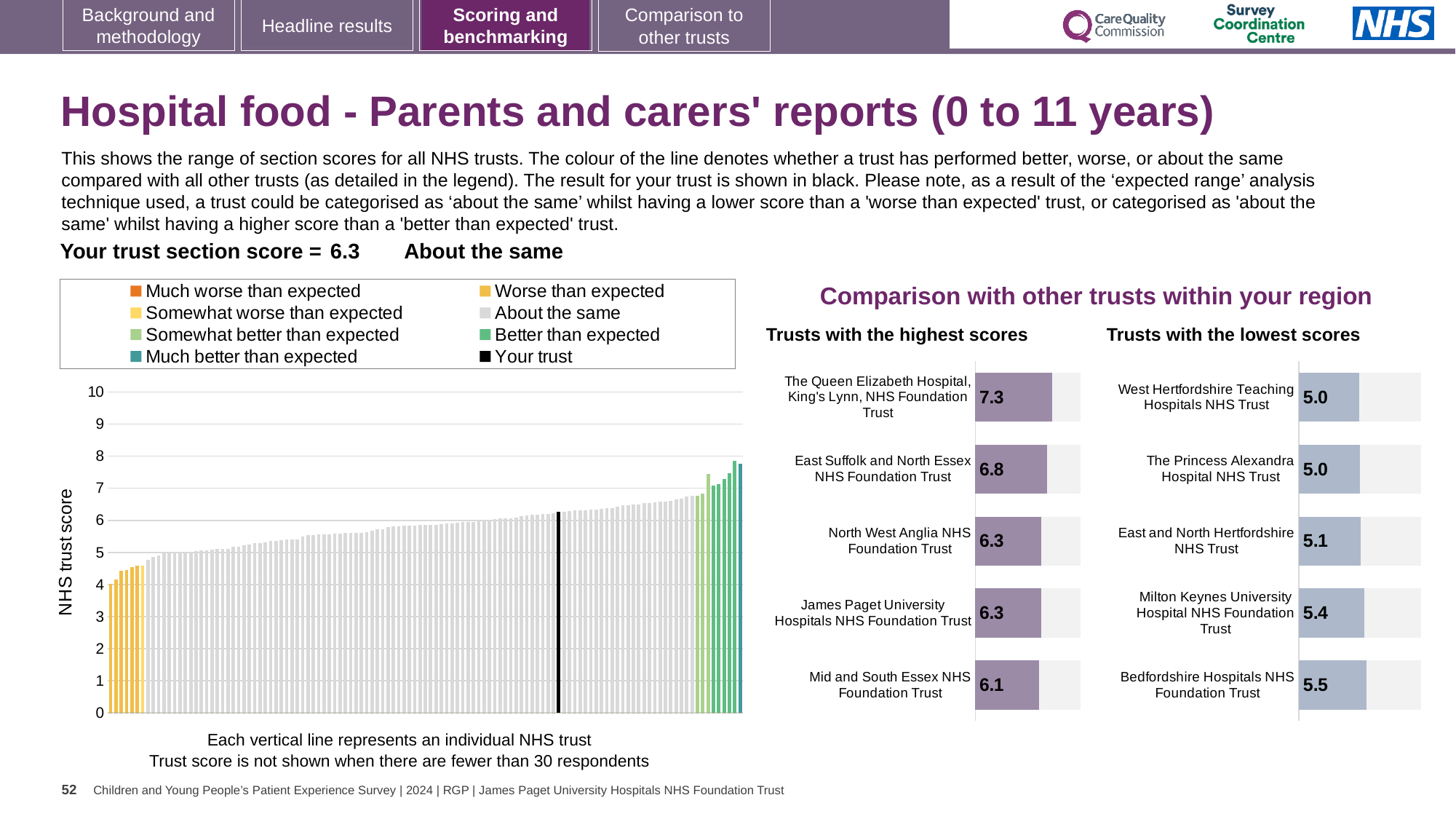
In the 'Trusts with the highest scores' chart, which trust has the highest score? The Queen Elizabeth Hospital, King's Lynn, NHS Foundation Trust In the large chart on the left, do the trust scores rise or fall from left to right? Rise In the 'Trusts with the highest scores' chart, what is the score for The Queen Elizabeth Hospital, King's Lynn, NHS Foundation Trust? 7.3 How many trusts are listed in the 'Trusts with the highest scores' chart? 5 In the 'Trusts with the lowest scores' chart, which trust has the highest score? Bedfordshire Hospitals NHS Foundation Trust What kind of chart is the large chart on the left showing NHS trust scores? Bar chart How many entries does the legend above the large chart on the left list? 8 In the 'Trusts with the lowest scores' chart, what is the score for Bedfordshire Hospitals NHS Foundation Trust? 5.5 In the 'Trusts with the highest scores' chart, which has the larger score: East Suffolk and North Essex NHS Foundation Trust or Mid and South Essex NHS Foundation Trust? East Suffolk and North Essex NHS Foundation Trust What is the section score for your trust, shown as the black bar in the large chart on the left? 6.3 In the 'Trusts with the highest scores' chart, what is the difference between the scores of The Queen Elizabeth Hospital, King's Lynn and Mid and South Essex NHS Foundation Trust? 1.2 In the 'Trusts with the lowest scores' chart, how much higher is Bedfordshire Hospitals NHS Foundation Trust's score than West Hertfordshire Teaching Hospitals NHS Trust's score? 0.5